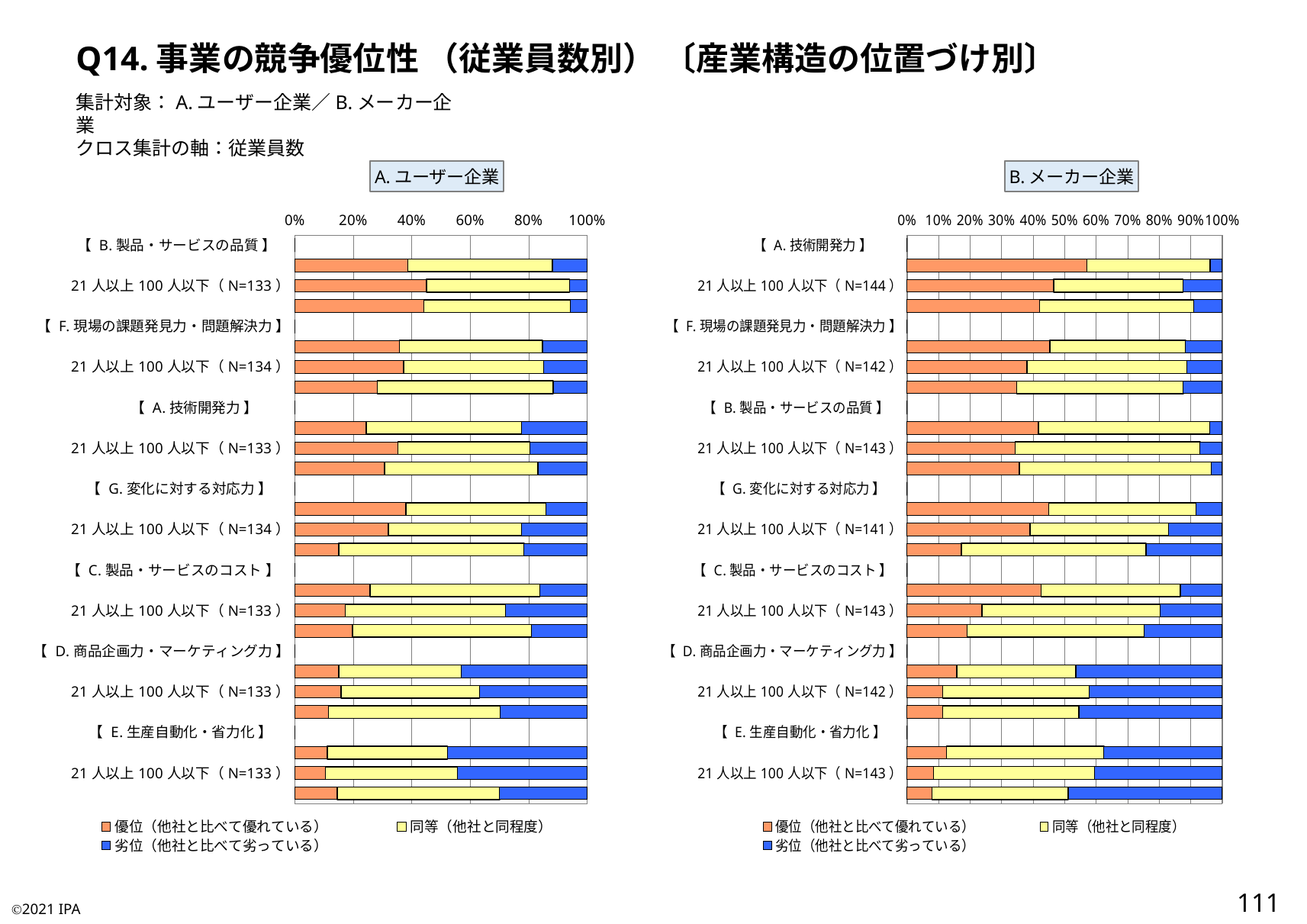
In the left chart (A. ユーザー企業), which has the larger 優位 share for 21 人以上 100 人以下 (N=133): 【 B. 製品・サービスの品質 】 or 【 E. 生産自動化・省力化 】? 【 B. 製品・サービスの品質 】 What kind of chart is the left chart titled A. ユーザー企業? stacked bar chart In the left chart (A. ユーザー企業), is the 優位 share for 21 人以上 100 人以下 (N=133) under 【 C. 製品・サービスのコスト 】 greater or less than 20%? less In the right chart (B. メーカー企業), is the 優位 share for 21 人以上 100 人以下 (N=144) under 【 A. 技術開発力 】 greater or less than 40%? greater In the left chart (A. ユーザー企業), is the 優位 share for 21 人以上 100 人以下 (N=133) under 【 E. 生産自動化・省力化 】 greater or less than 20%? less In the left chart (A. ユーザー企業), how many bracketed category groups (【 】 headings) are shown on the vertical axis? 7 Which legend entry is shown in blue in the right chart (B. メーカー企業)? 劣位（他社と比べて劣っている） How many series does the legend of the right chart (B. メーカー企業) list? 3